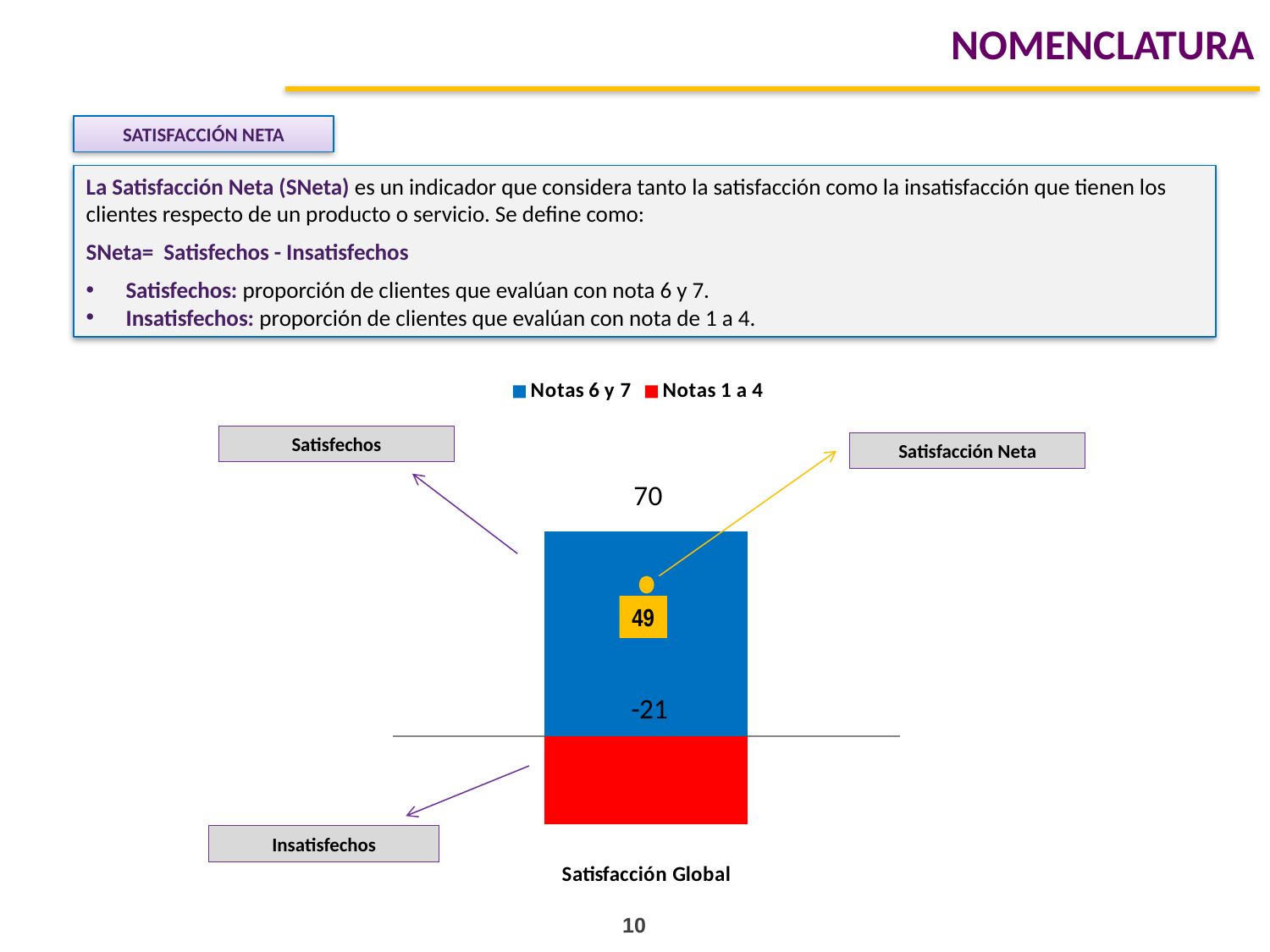
What value is shown in the yellow marker on the bar, representing Satisfacción Neta? 49 Which colour represents the "Notas 1 a 4" series in the chart? Red Which series is plotted below the horizontal axis line? Notas 1 a 4 What is the difference between the "Notas 6 y 7" value (70) and the absolute value of "Notas 1 a 4" (21)? 49 What is the value for the "Notas 1 a 4" series for Satisfacción Global? -21 What kind of chart is shown on the slide? Bar chart Which series has the larger absolute value, "Notas 6 y 7" or "Notas 1 a 4"? Notas 6 y 7 How many series does the chart legend list? 2 How many categories are plotted on the x axis of the chart? 1 What is the value for the "Notas 6 y 7" series for Satisfacción Global? 70 What is the category label shown below the bar? Satisfacción Global